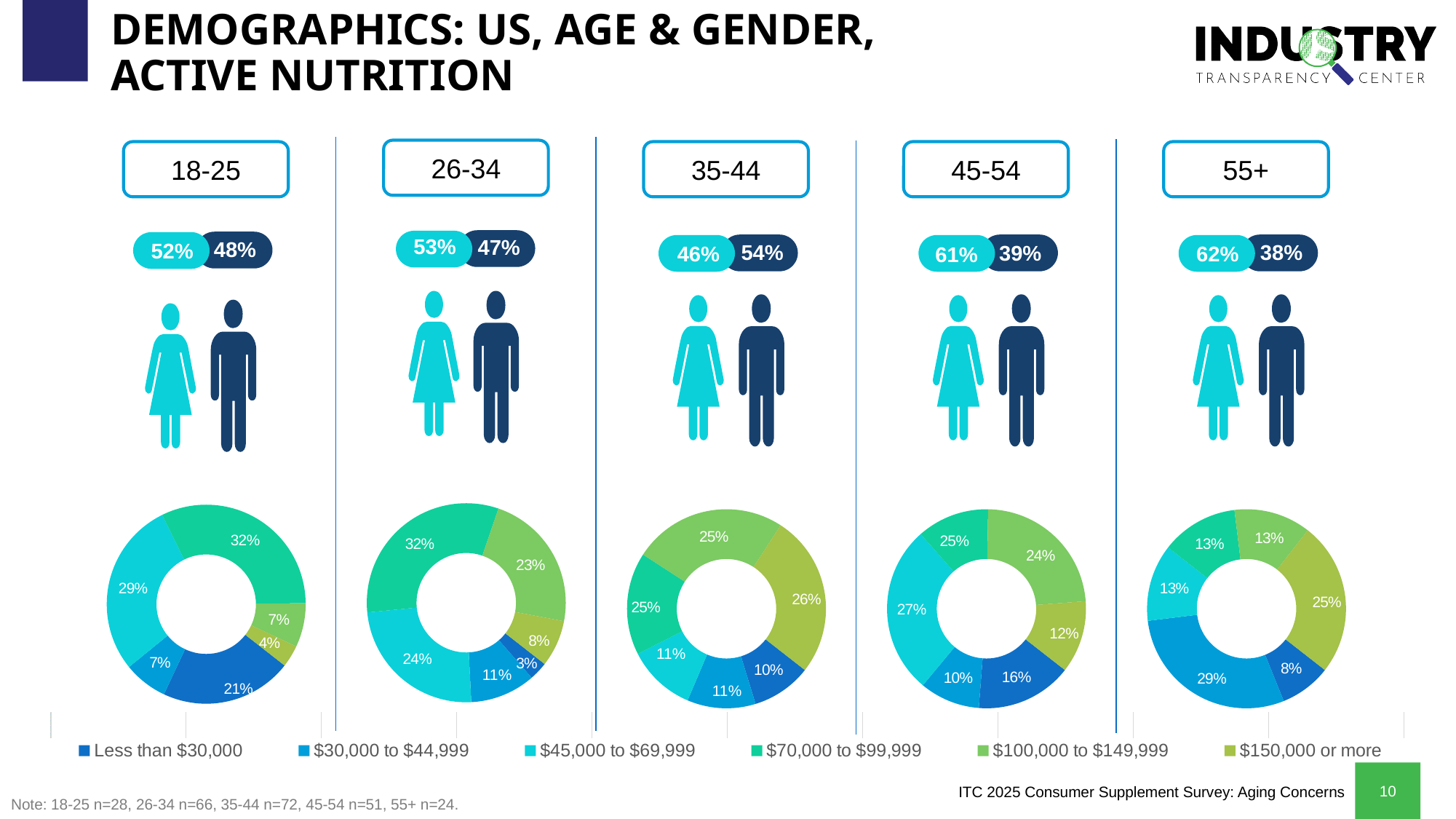
What percentage of the 55+ age group is female (cyan)? 62% In the 18-25 donut chart, what share of respondents earn $70,000 to $99,999? 32% In the 35-44 donut chart, what share of respondents earn $150,000 or more? 26% In the 18-25 donut chart, which is larger: the share earning $45,000 to $69,999 or the share earning less than $30,000? $45,000 to $69,999 In the 45-54 donut chart, what share of respondents earn $45,000 to $69,999? 27% In the 26-34 donut chart, which income bracket has the smallest share? Less than $30,000 In the 55+ donut chart, which income bracket has the largest share? $30,000 to $44,999 What kind of chart is used to show the income distribution for each age group? Donut chart In the 55+ donut chart, what share of respondents earn $30,000 to $44,999? 29% How many income brackets does the legend list? 6 In the 45-54 donut chart, what is the difference between the share earning $100,000 to $149,999 and the share earning $150,000 or more? 12% In the 26-34 donut chart, what share of respondents earn less than $30,000? 3%